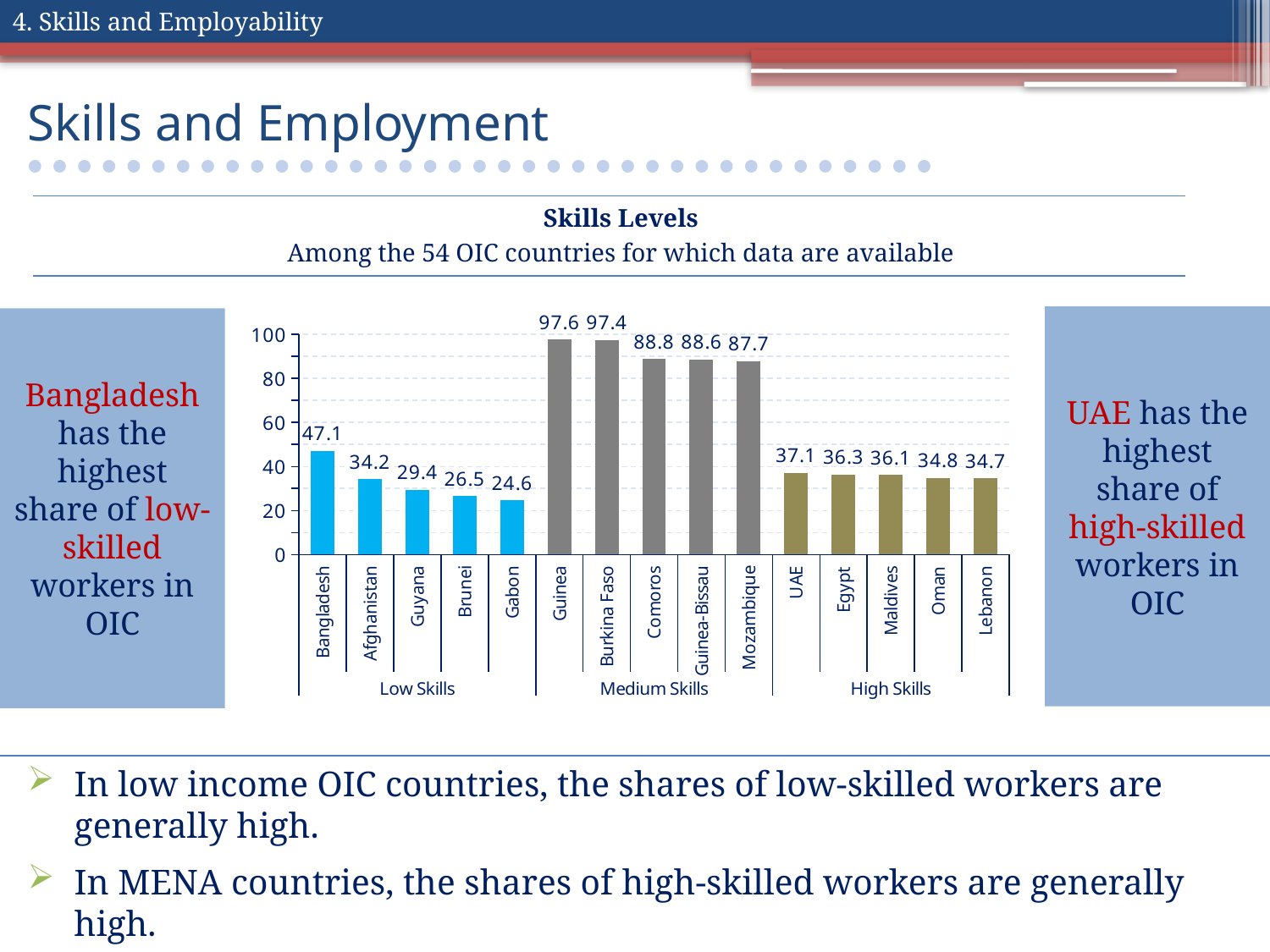
Which country has the lowest value on the chart? Gabon How many countries are shown on the chart? 15 What is the value for Gabon? 24.6 What is the value for Guinea in the Medium Skills group? 97.6 Which is larger, the value for Comoros or the value for Mozambique? Comoros Is the value for Brunei greater or less than 40? less What is the value for Bangladesh in the Low Skills group? 47.1 What kind of chart is shown on the slide? bar chart What is the difference between the values for Bangladesh and Afghanistan? 12.9 What are the three skill groups labelled on the x axis? Low Skills, Medium Skills, High Skills Which country has the highest value on the chart? Guinea What is the value for UAE in the High Skills group? 37.1